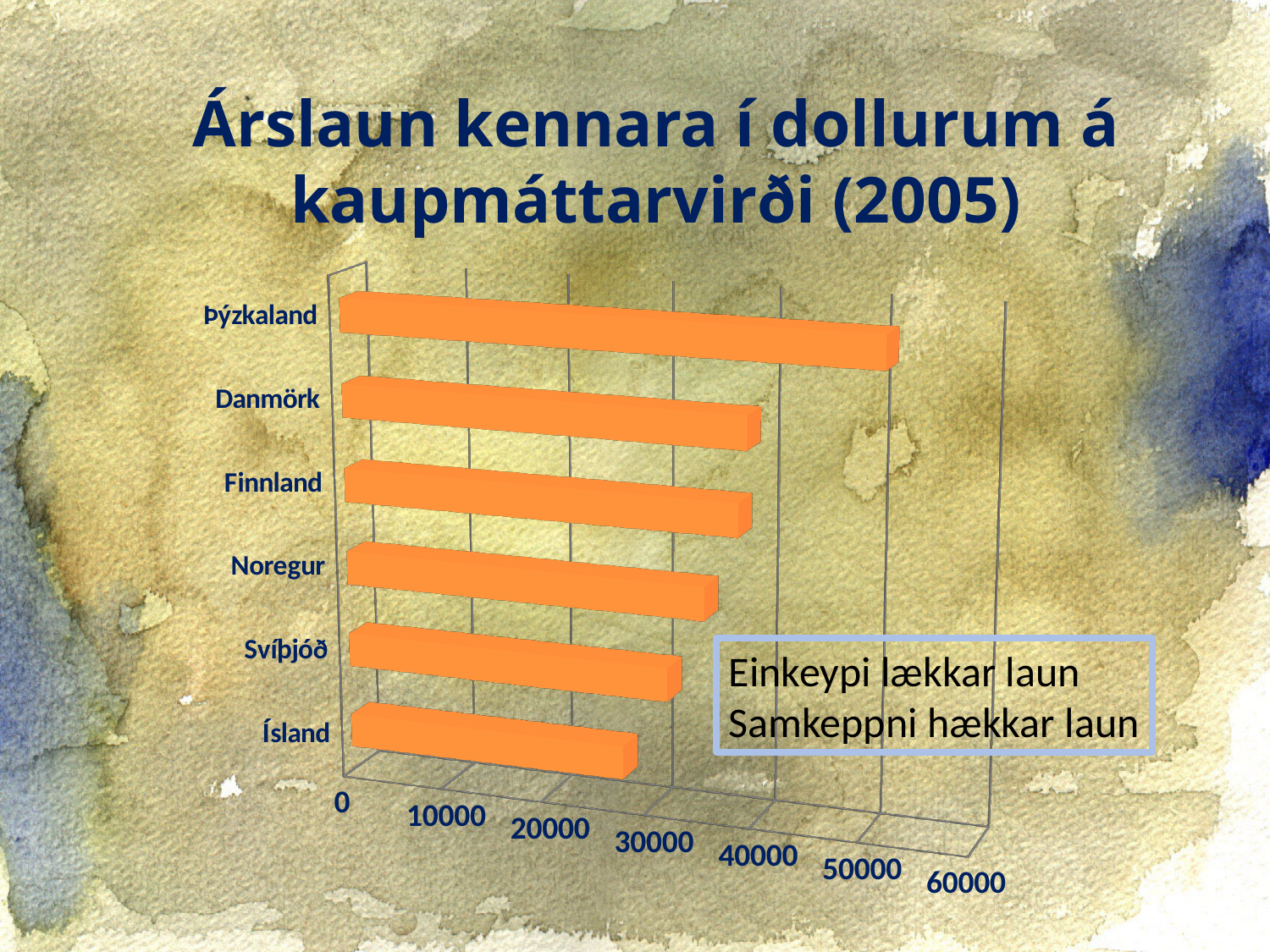
What kind of chart is shown on the slide? bar chart Which is larger, the value for Þýzkaland or the value for Ísland? Þýzkaland Is the value for Noregur greater or less than 40000? less Is the value for Ísland greater or less than 30000? less Is the value for Ísland greater or less than 20000? greater How many countries are shown in the chart? 6 What is the title of the chart on the slide? Árslaun kennara í dollurum á kaupmáttarvirði (2005) Do the bar values increase or decrease going from the top category to the bottom category? decrease Which country has the lowest teacher salary in the chart? Ísland Which country has the highest teacher salary in the chart? Þýzkaland